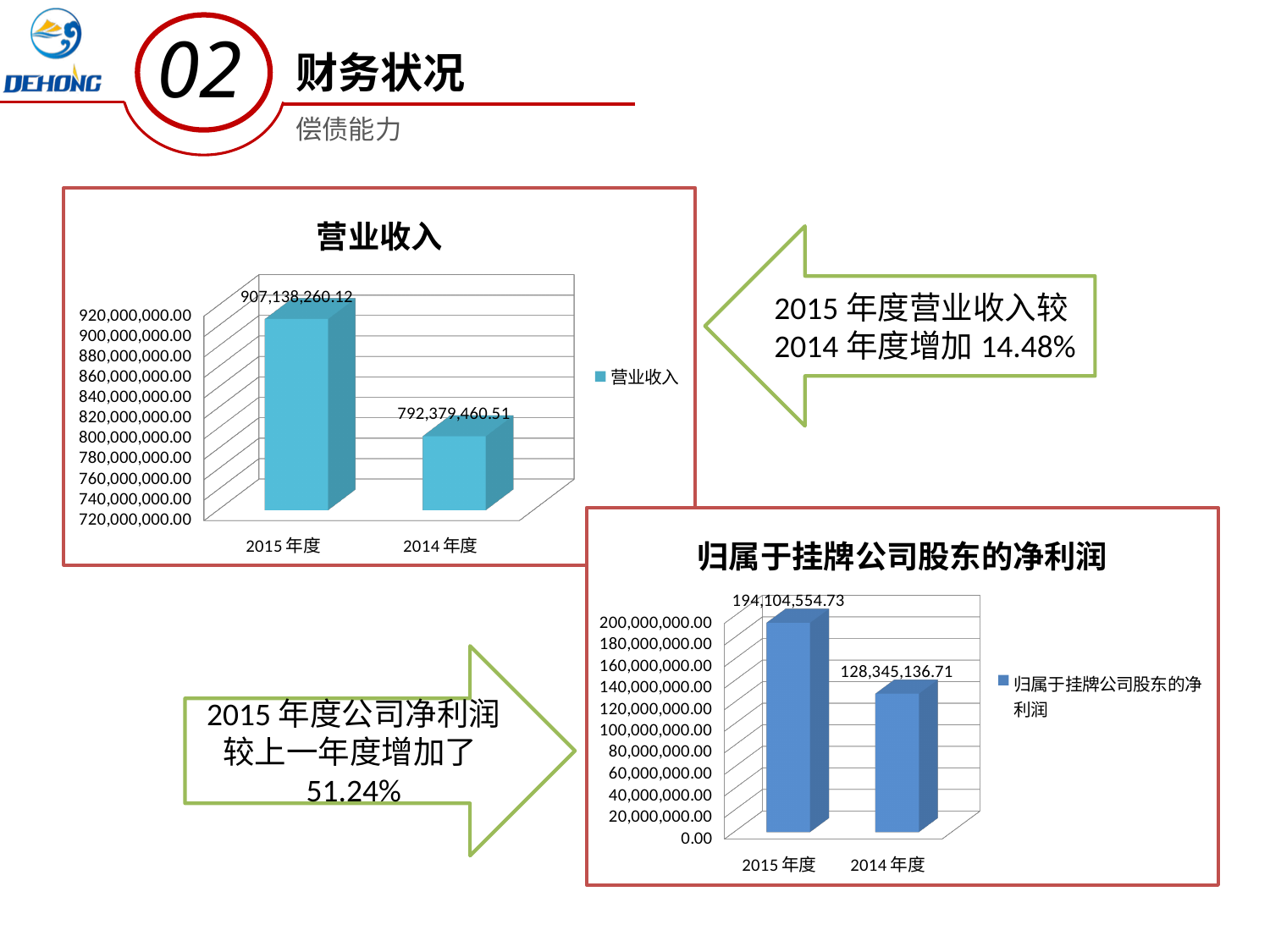
In the 归属于挂牌公司股东的净利润 chart, is the value for 2014 年度 greater or less than 140,000,000.00? less In the 归属于挂牌公司股东的净利润 chart, what is the value for 2014 年度? 128,345,136.71 In the 归属于挂牌公司股东的净利润 chart, what is the difference between the 2015 年度 and 2014 年度 values? 65,759,418.02 In the 营业收入 chart, how many categories are shown on the x axis? 2 In the 营业收入 chart, what is the value for 2015 年度? 907,138,260.12 What kind of chart is the 营业收入 chart? bar chart In the 归属于挂牌公司股东的净利润 chart, what is the value for 2015 年度? 194,104,554.73 How many series does the legend of the 归属于挂牌公司股东的净利润 chart list? 1 In the 营业收入 chart, what is the difference between the 2015 年度 and 2014 年度 values? 114,758,799.61 In the 营业收入 chart, which year has the higher value? 2015 年度 In the 归属于挂牌公司股东的净利润 chart, which year has the lower value? 2014 年度 In the 营业收入 chart, what is the value for 2014 年度? 792,379,460.51